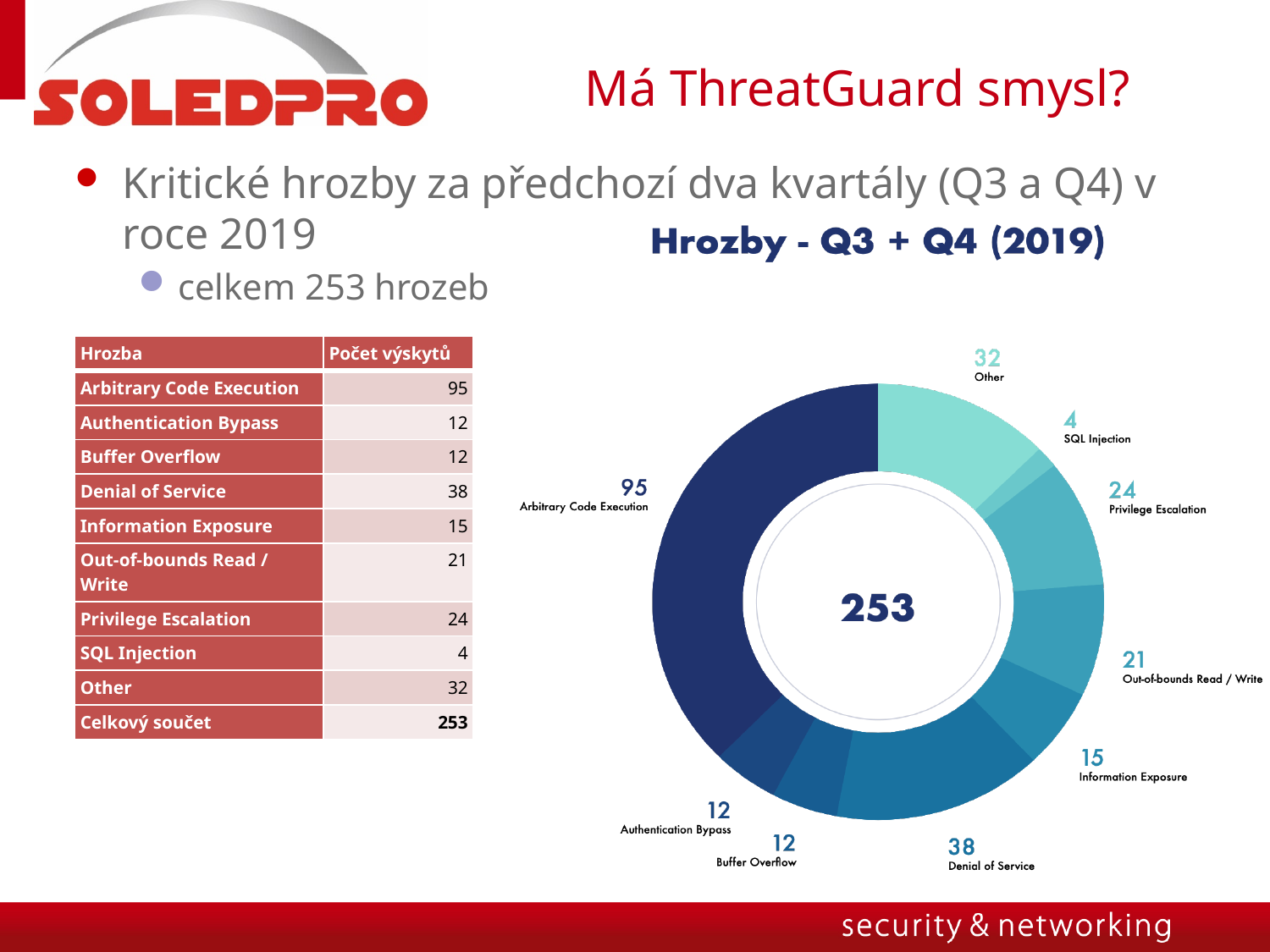
Which is larger, the value for Other or the value for Privilege Escalation? Other Which category has the lowest value in the chart? SQL Injection Which category has the highest value in the chart? Arbitrary Code Execution How many categories are shown in the chart? 9 What is the title of the chart? Hrozby - Q3 + Q4 (2019) What is the value for Arbitrary Code Execution in the chart? 95 What kind of chart is shown on the slide? donut chart What total is shown in the centre of the chart? 253 What is the value for SQL Injection in the chart? 4 What is the value for Denial of Service in the chart? 38 What is the value for Privilege Escalation in the chart? 24 What is the difference between the values for Arbitrary Code Execution and Denial of Service? 57